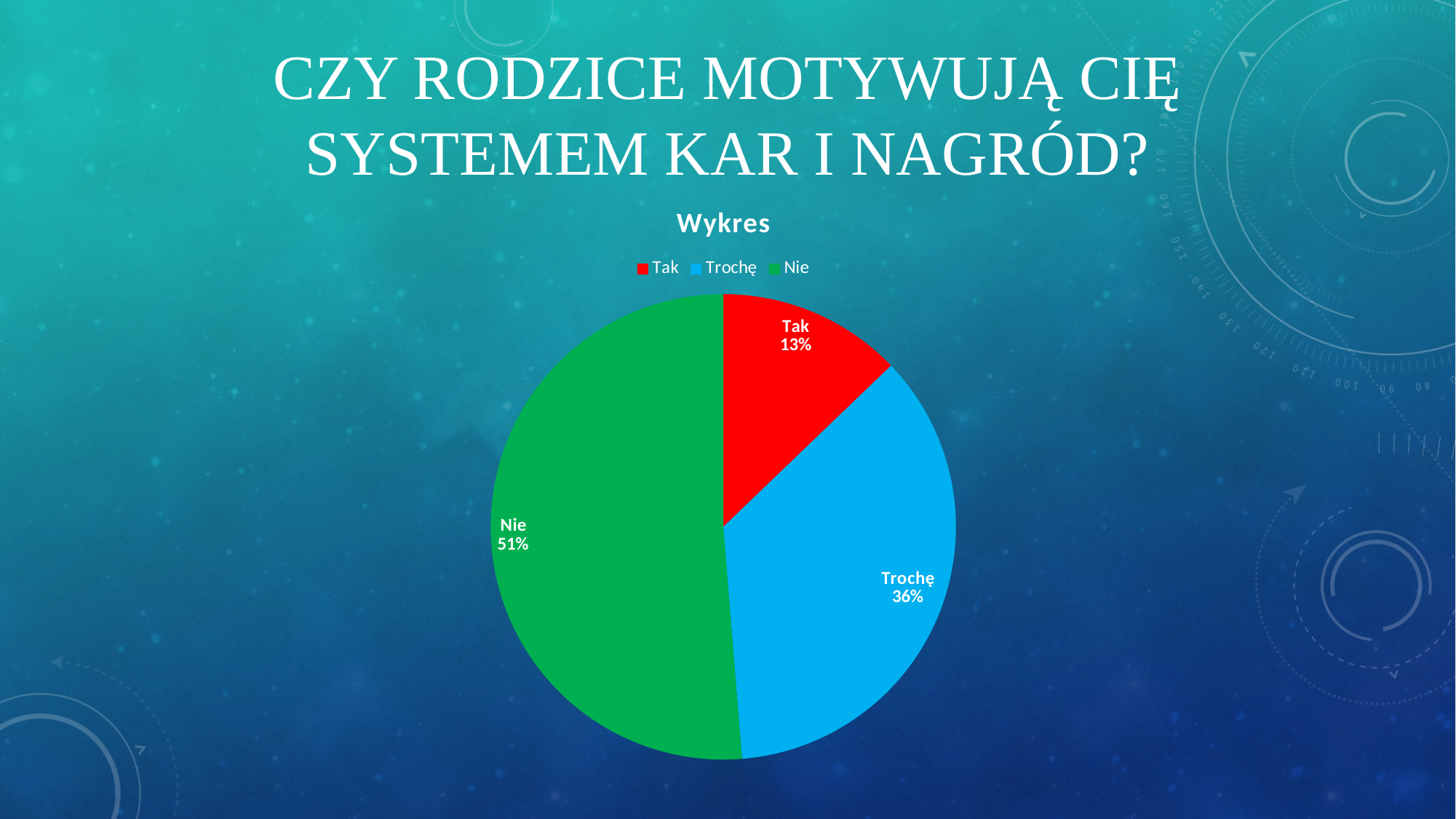
What share of the pie does the "Nie" slice represent? 51% How many entries does the legend list? 3 What is the difference in percentage points between the "Nie" and "Trochę" slices? 15% What is the title of the chart? Wykres Which slice is larger, "Trochę" or "Tak"? Trochę What share of the pie does the "Tak" slice represent? 13% What colour is the "Nie" slice? green How many slices does the pie chart have? 3 Which category has the smallest slice of the pie? Tak What type of chart is shown on the slide? pie chart What share of the pie does the "Trochę" slice represent? 36% Which category has the largest slice of the pie? Nie